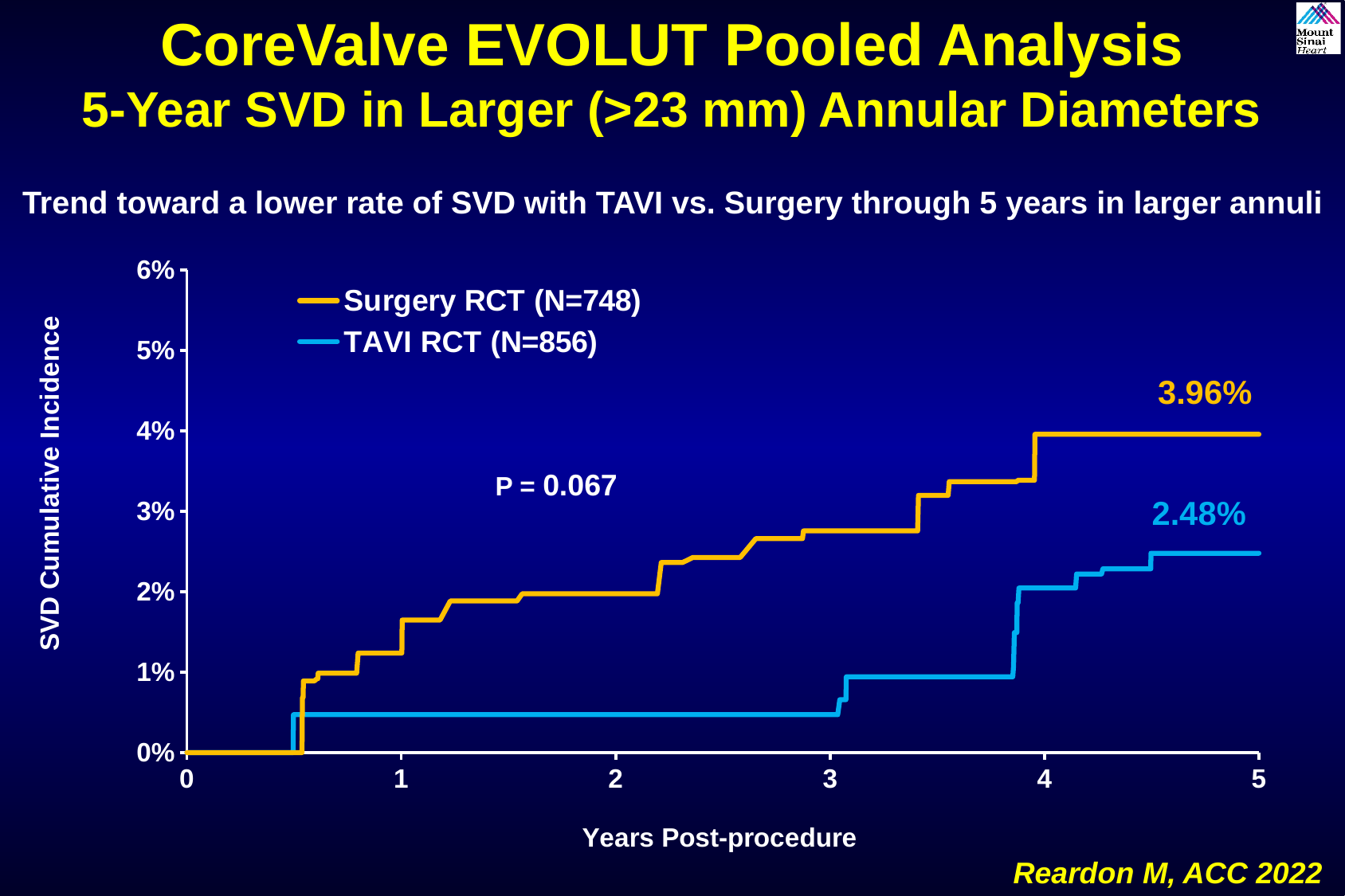
What is the difference between the Surgery RCT and TAVI RCT SVD cumulative incidence at 5 years? 1.48% What is the label of the y axis? SVD Cumulative Incidence What is the sample size (N) of the TAVI RCT group shown in the legend? 856 Which group has the higher SVD cumulative incidence at 5 years? Surgery RCT What kind of chart is shown on the slide? Line chart What is the P value shown on the chart? P = 0.067 What is the 5-year SVD cumulative incidence for the Surgery RCT group? 3.96% How many series does the legend list? 2 Is the SVD cumulative incidence for the TAVI RCT group at 3 years greater or less than 1%? less Does the SVD cumulative incidence for the Surgery RCT group rise or fall over the years post-procedure? Rise What is the 5-year SVD cumulative incidence for the TAVI RCT group? 2.48% Is the SVD cumulative incidence for the Surgery RCT group at 2 years greater or less than 1%? greater